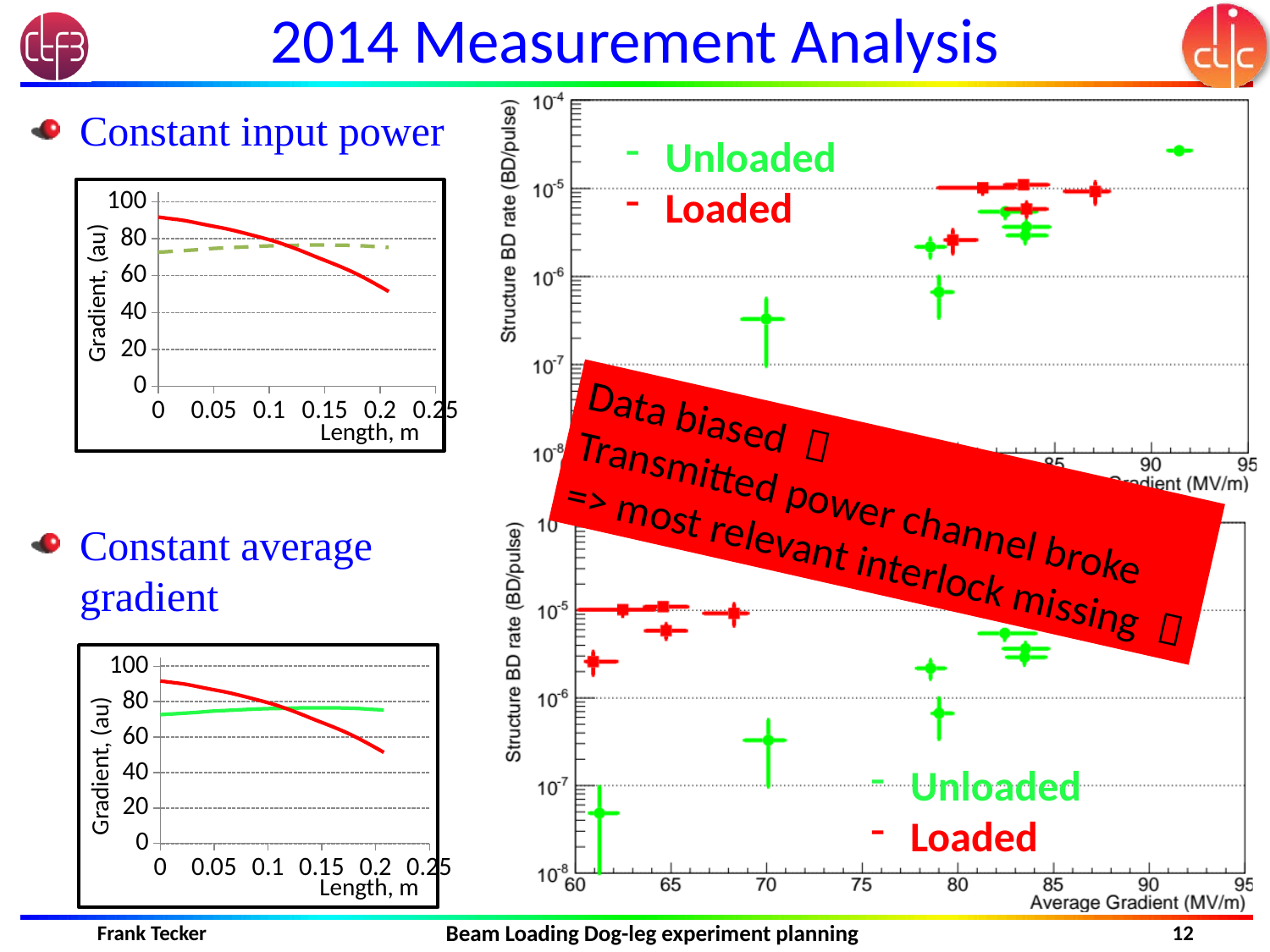
In the lower scatter plot on the right, which series is drawn in red according to the legend? Loaded In the 'Constant average gradient' chart, at length 0.2, which line has the larger value, the red line or the green line? the green line In the 'Constant average gradient' chart, is the value of the green line at length 0 greater or less than 80? less In the 'Constant input power' chart, what is the label of the y axis? Gradient, (au) In the 'Constant input power' chart, what is the label of the x axis? Length, m In the 'Constant input power' chart, is the value of the red line at length 0 greater or less than 80? greater In the 'Constant input power' chart, at length 0, which line has the larger value, the red line or the green dashed line? the red line In the 'Constant average gradient' chart, does the green line rise or fall as length increases from 0 to 0.1? rise In the 'Constant input power' chart, does the red line rise or fall as length increases? fall In the upper scatter plot on the right, how many series does the legend list? 2